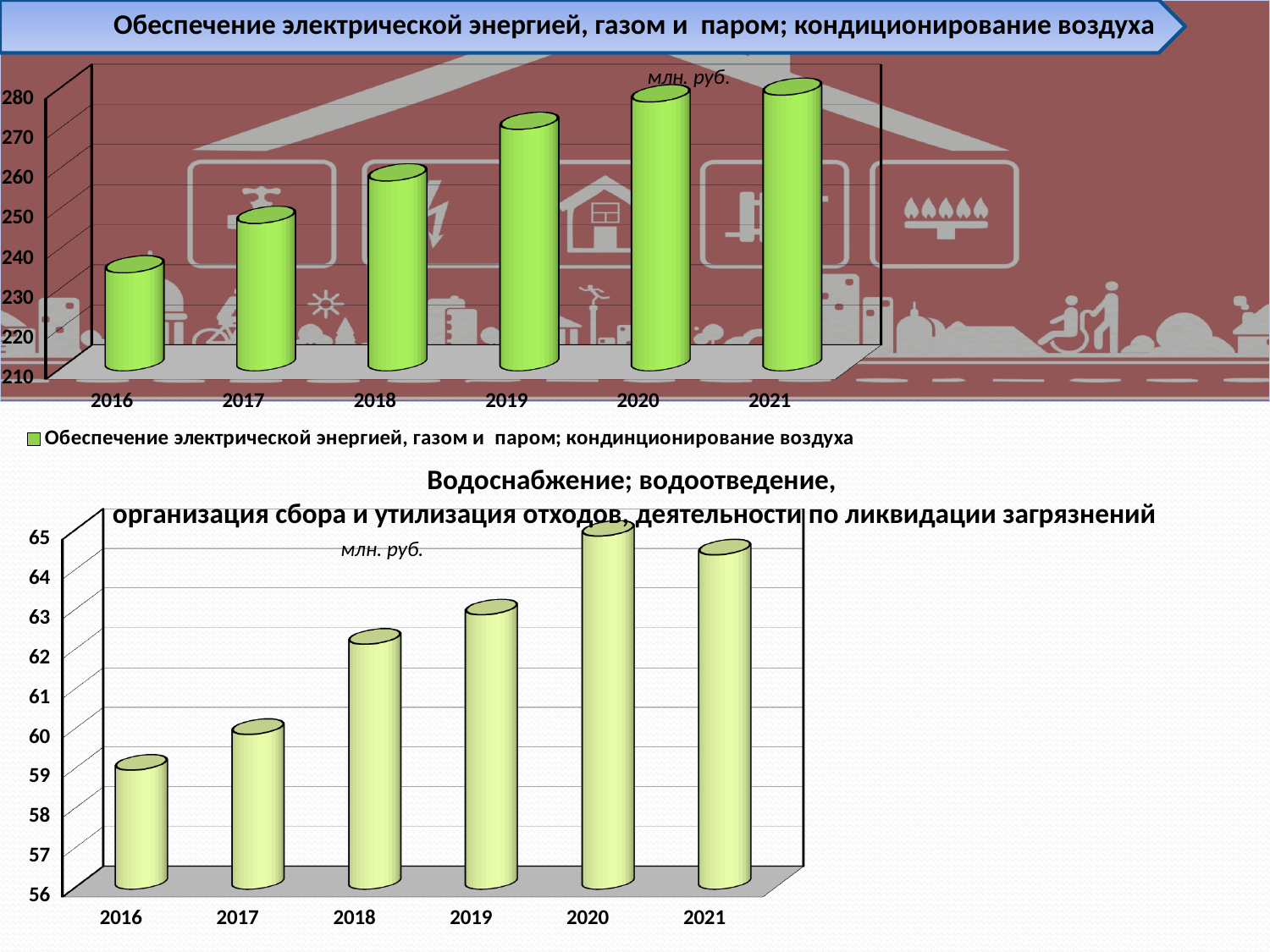
In the top chart (Обеспечение электрической энергией, газом и паром), which year has the lowest value? 2016 In the bottom chart (Водоснабжение; водоотведение), which year has the lowest value? 2016 In the top chart (Обеспечение электрической энергией, газом и паром), is the value for 2017 greater or less than 250? less In the bottom chart (Водоснабжение; водоотведение), is the value for 2016 greater or less than 58? greater What type of chart is the top chart on the slide? bar chart In the bottom chart (Водоснабжение; водоотведение), which is larger, the value for 2020 or the value for 2021? 2020 In the top chart (Обеспечение электрической энергией, газом и паром), is the value for 2016 greater or less than 240? less In the top chart (Обеспечение электрической энергией, газом и паром), how many years are shown on the x axis? 6 In the bottom chart (Водоснабжение; водоотведение), which year has the highest value? 2020 In the top chart (Обеспечение электрической энергией, газом и паром), do the values rise or fall from 2016 to 2021? rise In the top chart (Обеспечение электрической энергией, газом и паром), which year has the highest value? 2021 What unit is indicated on the top chart? млн. руб.